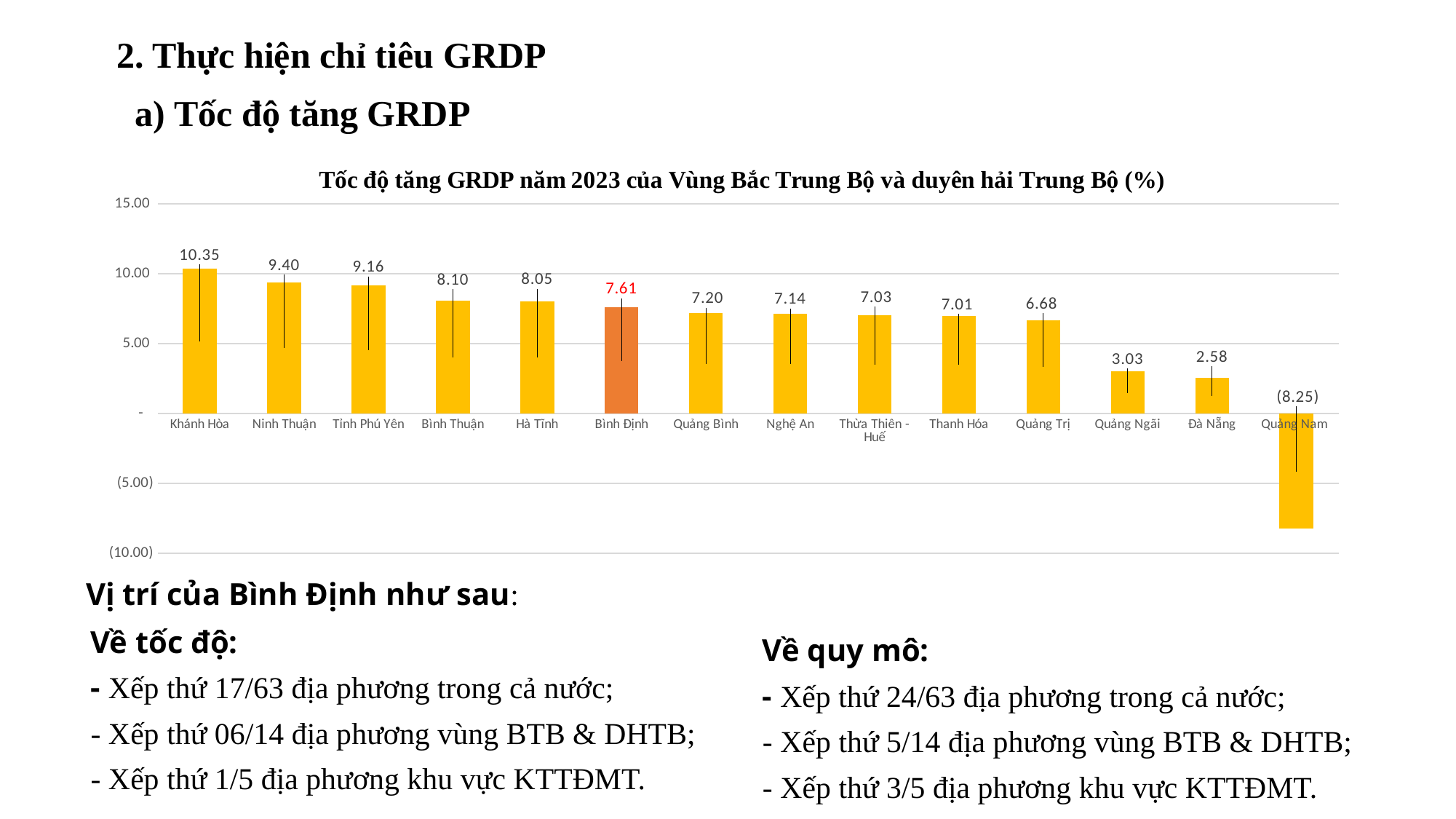
What value is shown for Quảng Nam? (8.25) Do the values generally rise or fall from left to right across the chart? Fall Which province has the lowest value in the chart? Quảng Nam What kind of chart is shown on the slide? Bar chart What is the difference between the values for Khánh Hòa and Ninh Thuận? 0.95 How many provinces are shown in the chart? 14 Is the value for Quảng Trị greater or less than 5.00? greater Which bar is highlighted in a different colour (orange) from the others? Bình Định What is the GRDP growth rate shown for Bình Định? 7.61 What is the value shown for Khánh Hòa? 10.35 Which is larger, the value for Quảng Ngãi or the value for Đà Nẵng? Quảng Ngãi Which province has the highest GRDP growth rate in the chart? Khánh Hòa